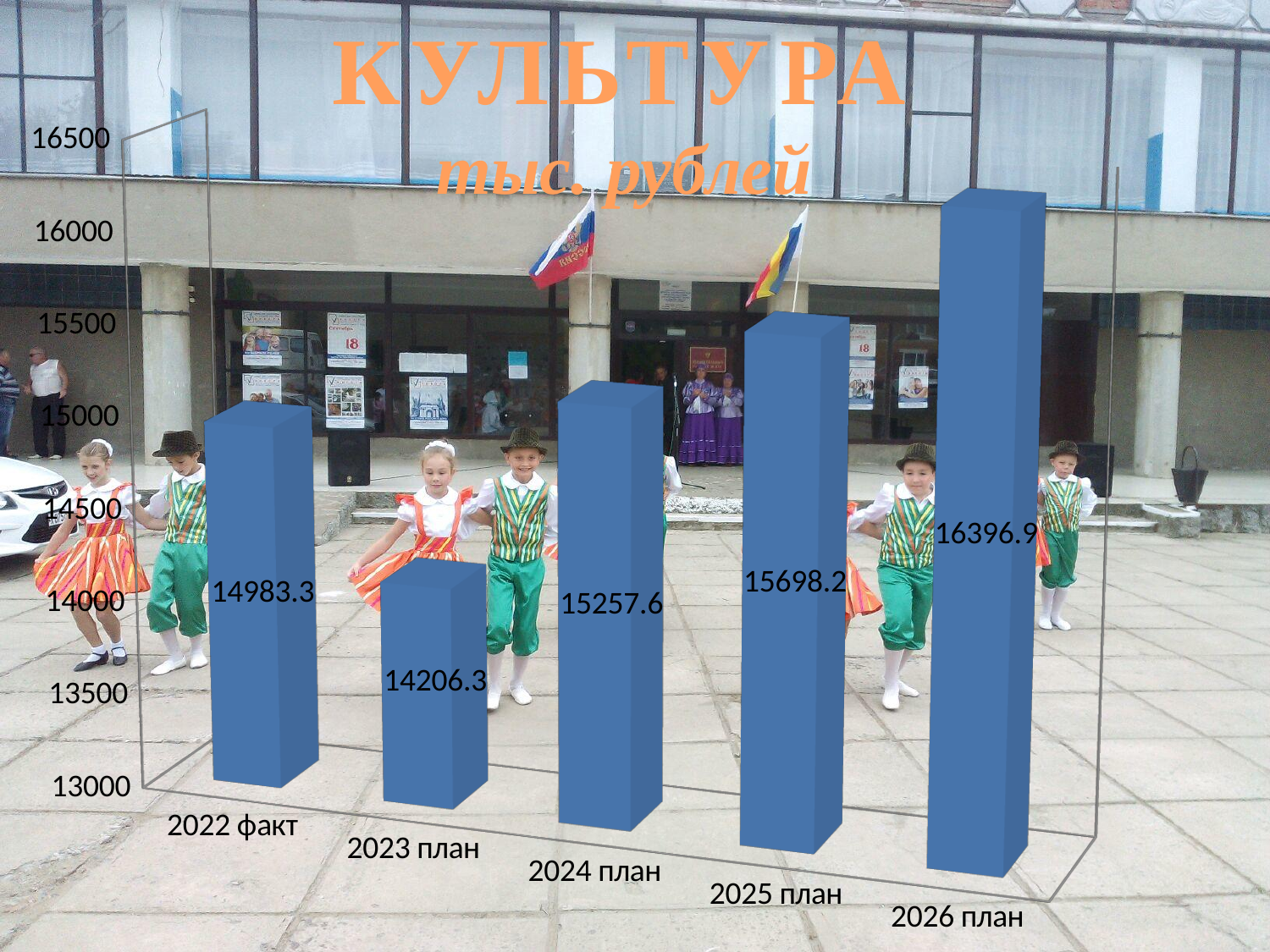
What is the value for 2025 план? 15698.2 Which category has the lowest value? 2023 план What kind of chart is shown on the slide? bar chart How many categories are shown on the x axis? 5 Is the value for 2023 план greater or less than 14500? less What is the value for 2023 план? 14206.3 Which is larger, the value for 2024 план or the value for 2022 факт? 2024 план What is the difference between the values for 2026 план and 2025 план? 698.7 From 2023 план to 2026 план, do the values rise or fall? rise What is the value for 2022 факт? 14983.3 Which category has the highest value? 2026 план What is the difference between the values for 2022 факт and 2023 план? 777.0